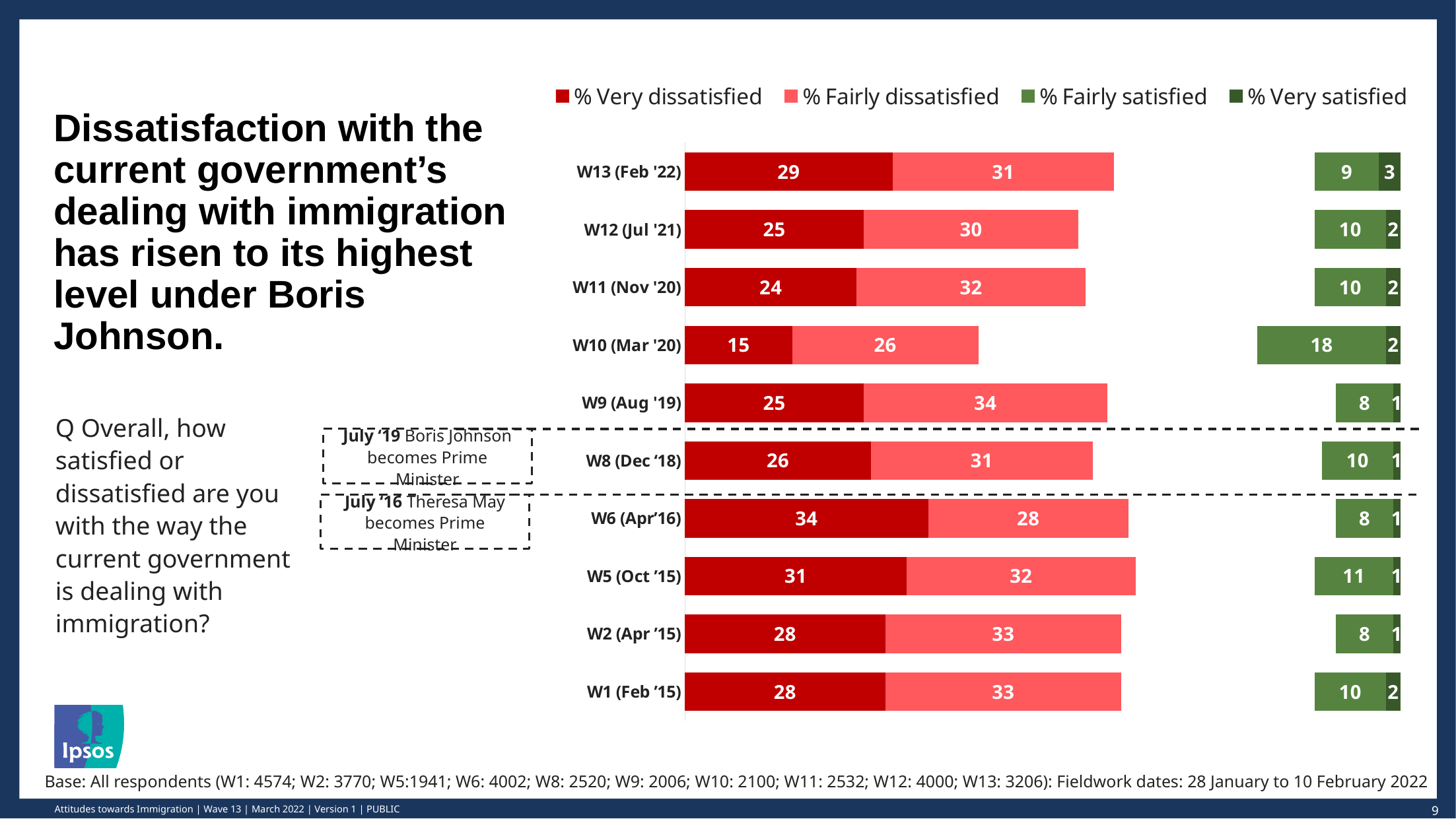
What type of chart is shown on the slide? Stacked bar chart What percentage of respondents were very dissatisfied in W13 (Feb '22)? 29 How many waves are shown in the chart? 10 What is the % Fairly satisfied value for W10 (Mar '20)? 18 Which wave has the lowest % Very dissatisfied value? W10 (Mar '20) How many series does the legend list? 4 What is the combined % Very dissatisfied and % Fairly dissatisfied for W13 (Feb '22)? 60 Which wave has the highest % Very dissatisfied value? W6 (Apr '16) Which wave has the highest % Fairly satisfied value? W10 (Mar '20) What is the % Very satisfied value for W13 (Feb '22)? 3 Which has a larger % Fairly dissatisfied value, W9 (Aug '19) or W13 (Feb '22)? W9 (Aug '19) What is the difference between the % Very dissatisfied values for W13 (Feb '22) and W12 (Jul '21)? 4